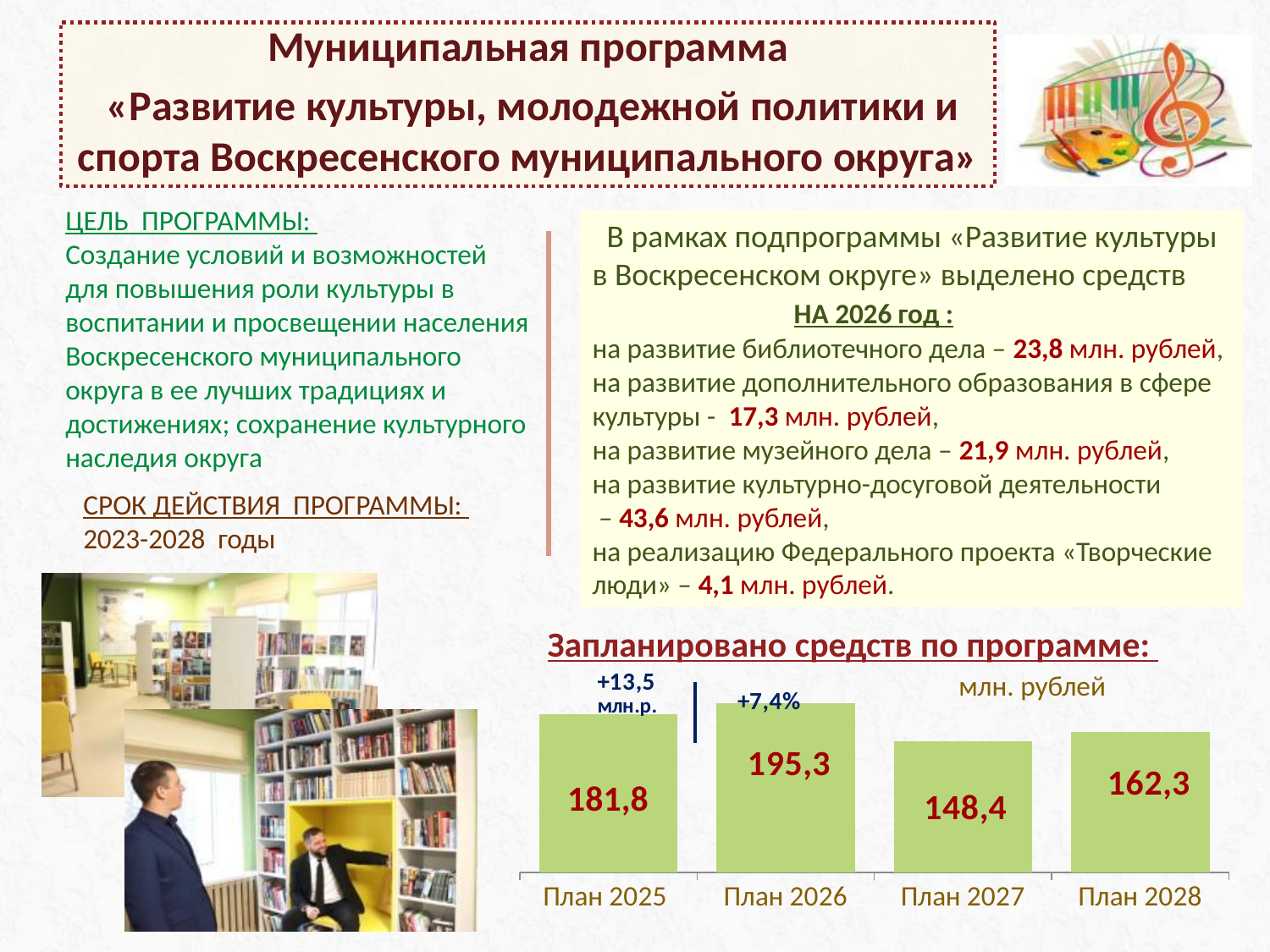
What is the planned amount for План 2026 in the chart 'Запланировано средств по программе'? 195,3 Which year has the lowest planned amount in the chart? План 2027 Does the planned amount rise or fall from План 2026 to План 2027? Fall Which is larger, the planned amount for План 2025 or for План 2028? План 2025 Which year has the highest planned amount in the chart? План 2026 What is the difference between the planned amounts for План 2026 and План 2025? 13,5 What type of chart is used to show the planned funds by programme? Bar chart How many years (bars) are shown in the chart? 4 What is the difference between the planned amounts for План 2028 and План 2027? 13,9 In what units are the values in the chart expressed? млн. рублей What is the planned amount for План 2025 in the chart? 181,8 What is the planned amount for План 2028 in the chart? 162,3